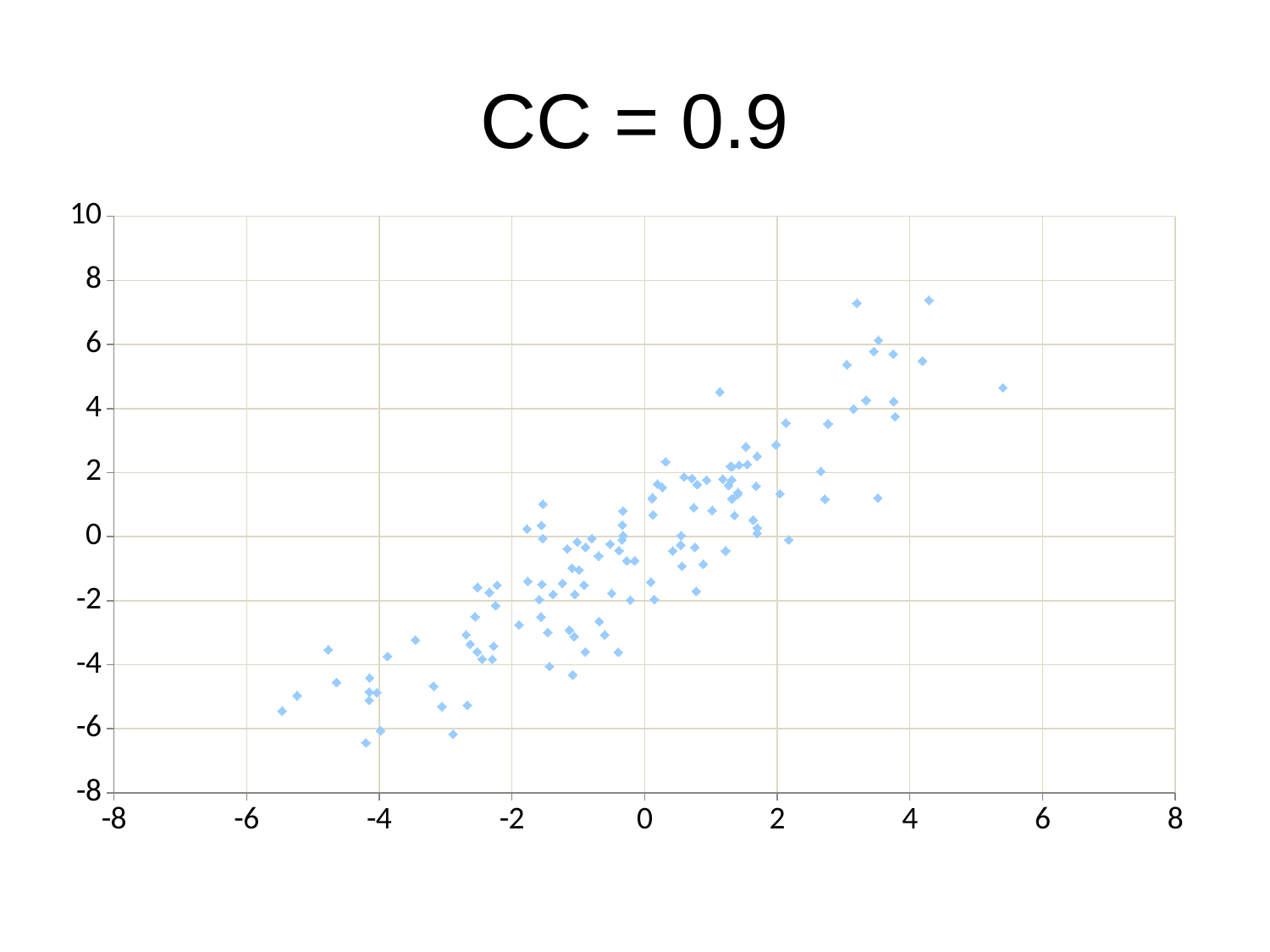
Is the lowest plotted y value greater or less than -4? less Is the smallest plotted x value greater or less than -4? less What range does the y axis cover, from its lowest to its highest tick? -8 to 10 Is the highest plotted y value greater or less than 6? greater As the x values increase, do the plotted y values generally rise or fall? rise What kind of chart is shown on the slide? scatter plot What is the title of the chart? CC = 0.9